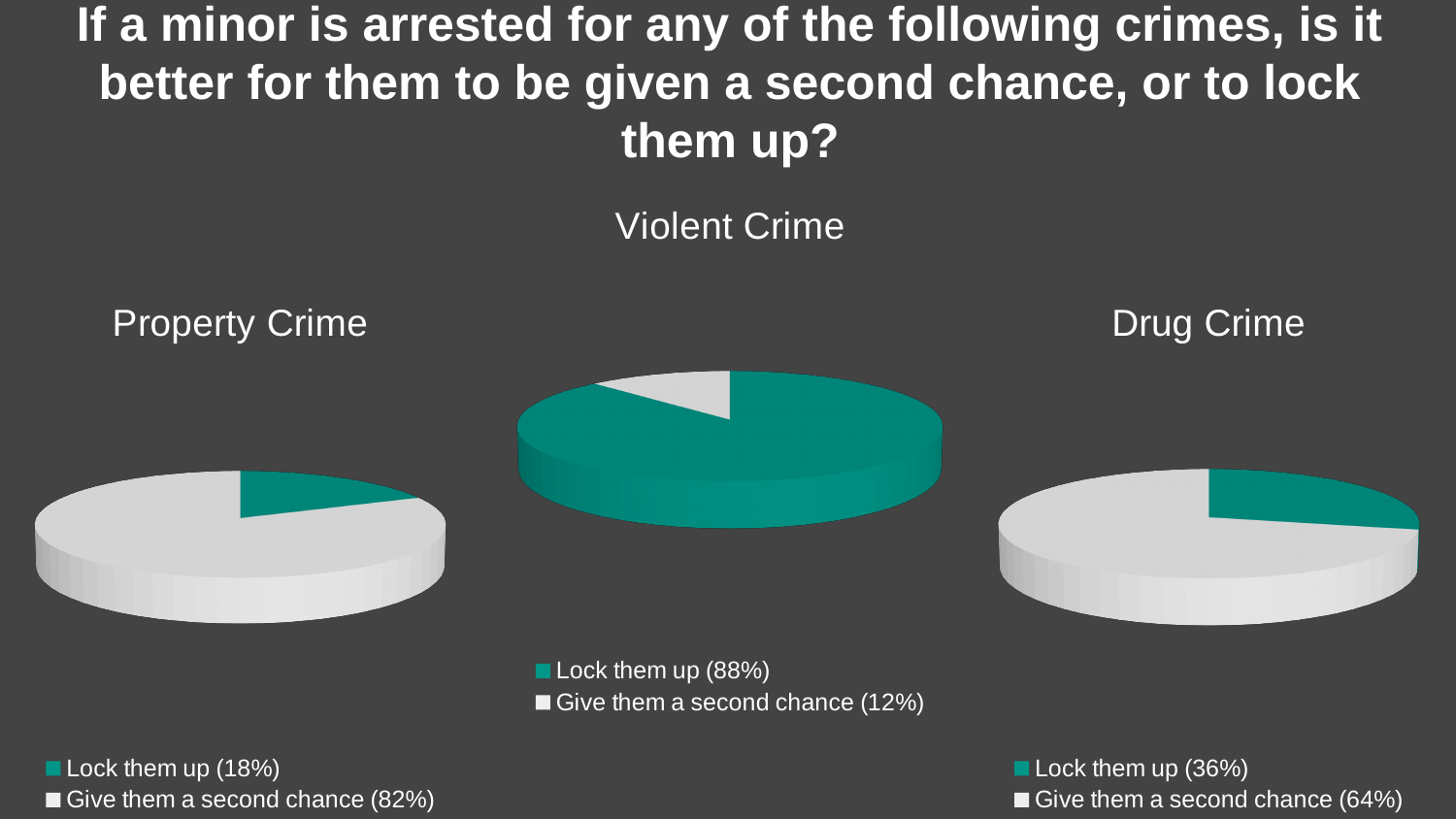
In the Property Crime chart, which option has the smaller share? Lock them up In the Property Crime chart, what percentage chose "Give them a second chance"? 82% In the Violent Crime chart, what percentage chose "Lock them up"? 88% What type of chart is used for Property Crime? Pie chart In the Drug Crime chart, what percentage chose "Give them a second chance"? 64% In the Violent Crime chart, which option has the larger share? Lock them up In the Drug Crime chart, what percentage chose "Lock them up"? 36% Is the "Lock them up" share larger in the Drug Crime chart or the Property Crime chart? Drug Crime How many slices does the Drug Crime chart have? 2 In the Drug Crime chart, what is the difference between "Give them a second chance" and "Lock them up"? 28% How many charts are shown on the slide? 3 In the Violent Crime chart, what is the difference between "Lock them up" and "Give them a second chance"? 76%